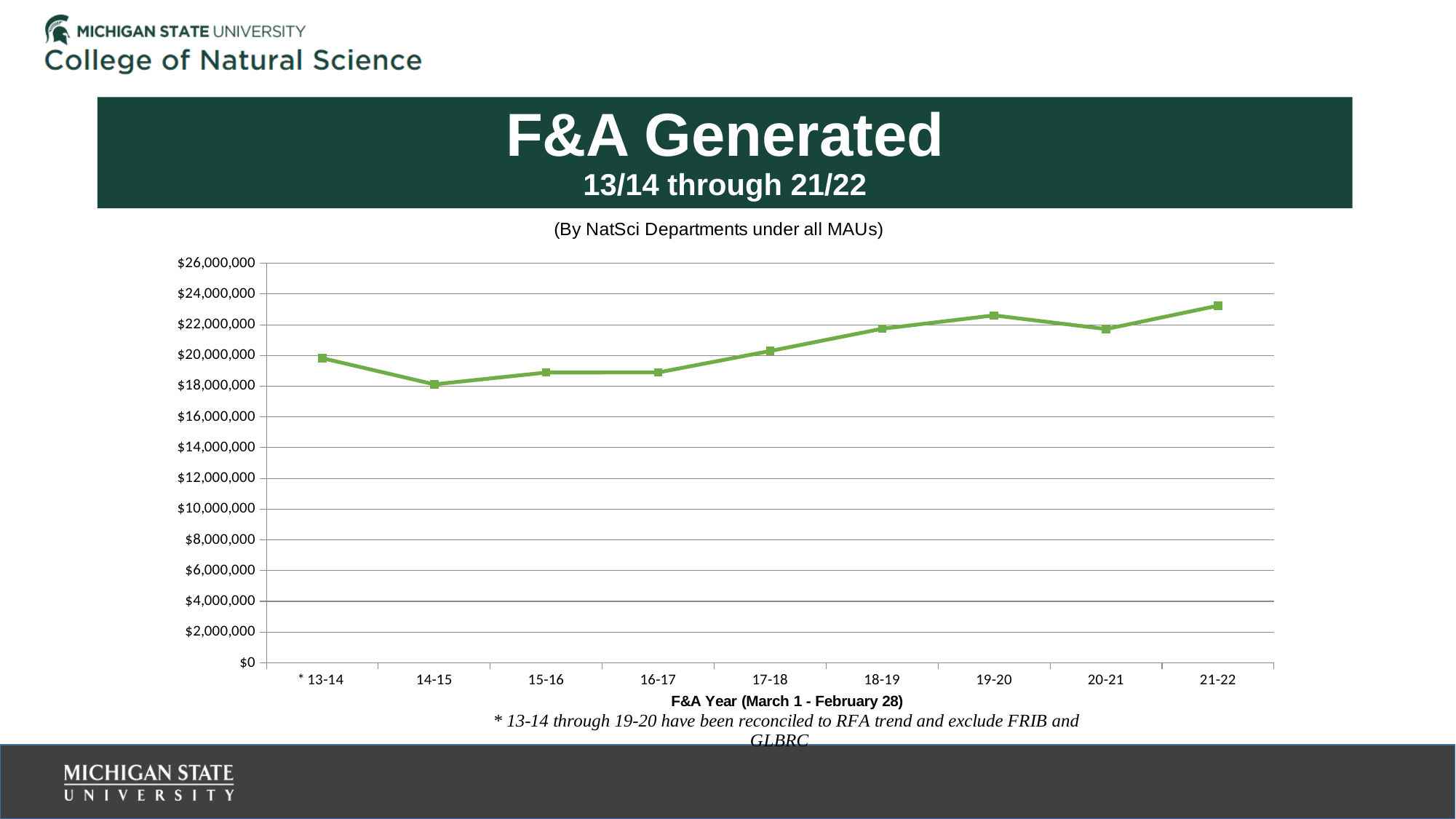
Is the value for 21-22 greater or less than $22,000,000? greater Which F&A year has the lowest F&A generated? 14-15 Overall, do the values rise or fall from 13-14 to 21-22? rise Which is larger, the value for 19-20 or the value for 20-21? 19-20 Is the value for 19-20 greater or less than $22,000,000? greater What is the title of the x axis? F&A Year (March 1 - February 28) Which F&A year has the highest F&A generated? 21-22 What kind of chart is shown on the slide? line chart Is the value for 14-15 greater or less than $20,000,000? less Which is larger, the value for 13-14 or the value for 14-15? 13-14 How many F&A years are plotted on the chart? 9